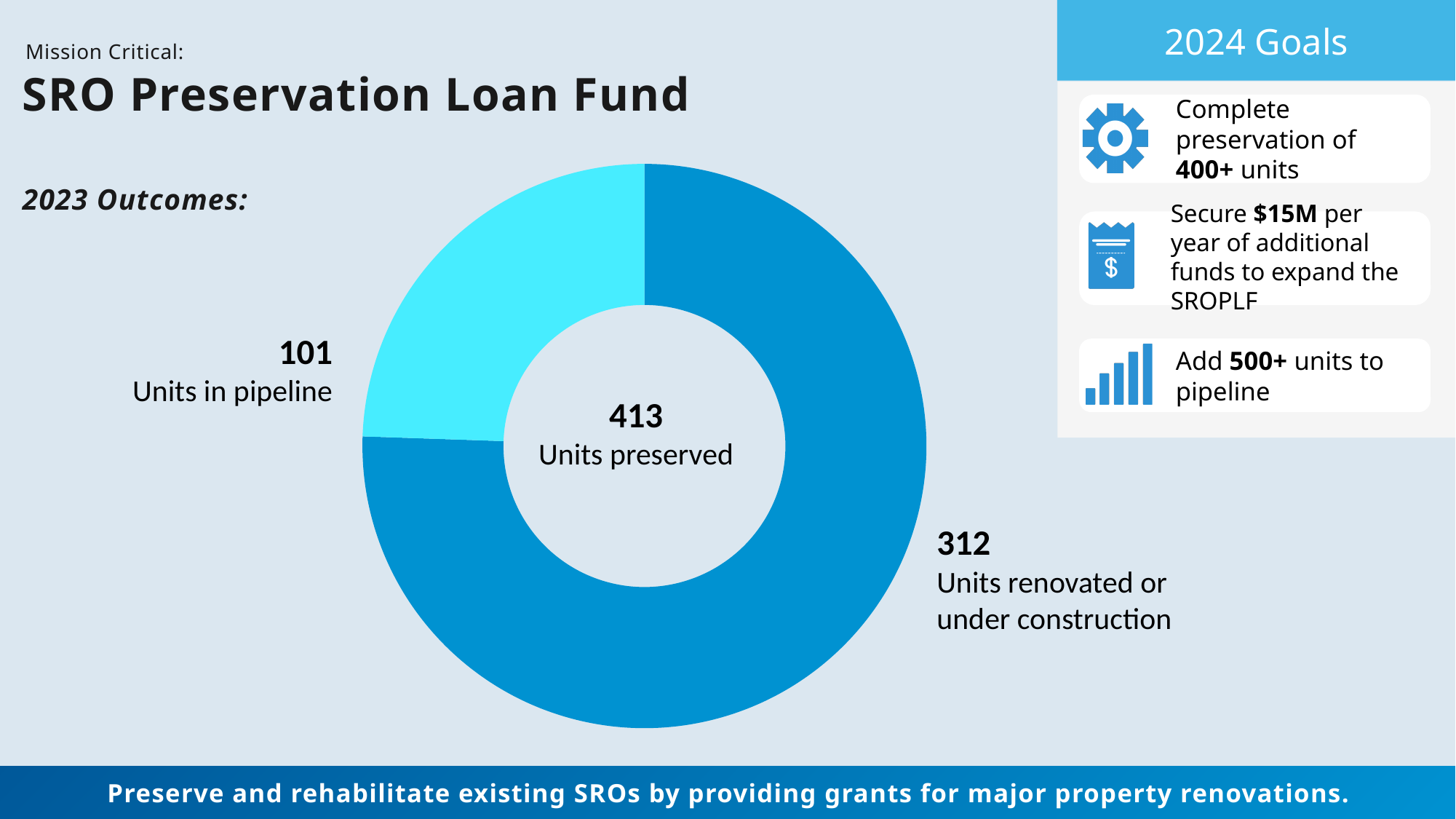
What total number of units preserved is shown in the centre of the donut chart? 413 How many units are in the pipeline according to the 2023 Outcomes chart? 101 Which category in the 2023 Outcomes chart has the larger value? Units renovated or under construction What is the difference between units renovated or under construction and units in pipeline? 211 Is the value for units renovated or under construction larger or smaller than the value for units in pipeline? larger Which category in the 2023 Outcomes chart has the smaller value? Units in pipeline What label appears in the centre of the donut chart? 413 Units preserved What kind of chart is used to show the 2023 Outcomes? donut chart How many units are renovated or under construction according to the 2023 Outcomes chart? 312 How many categories (slices) does the 2023 Outcomes donut chart show? 2 What is the sum of the two slices in the 2023 Outcomes chart? 413 Which colour represents units in pipeline in the donut chart? light cyan